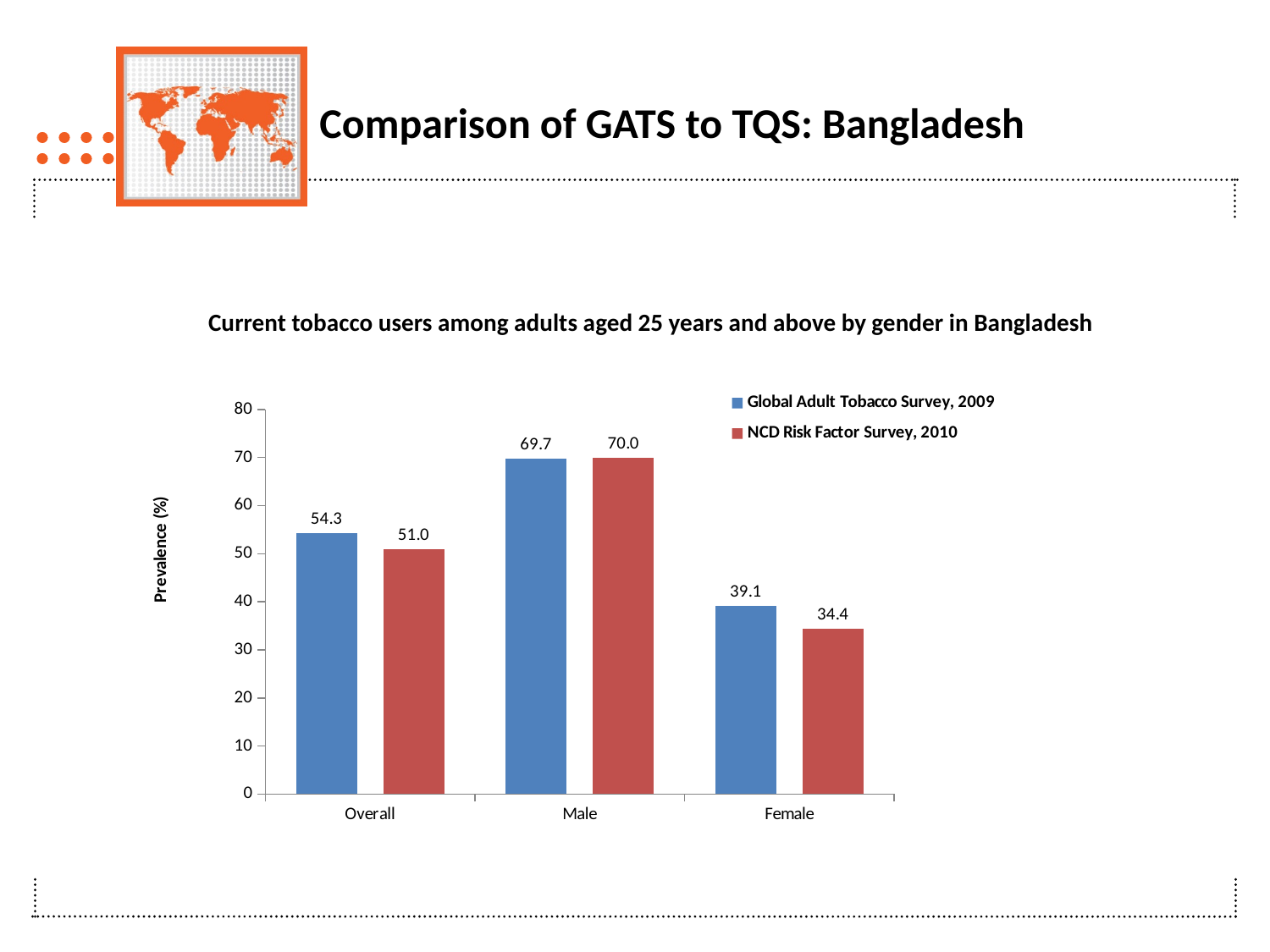
For Overall, which series has the larger value: Global Adult Tobacco Survey, 2009 or NCD Risk Factor Survey, 2010? Global Adult Tobacco Survey, 2009 What is the value for Female in the NCD Risk Factor Survey, 2010 series? 34.4 What is the value for Male in the Global Adult Tobacco Survey, 2009 series? 69.7 How many categories are shown on the x axis? 3 What is the difference between the Global Adult Tobacco Survey, 2009 and NCD Risk Factor Survey, 2010 values for Female? 4.7 What kind of chart is shown on the slide? bar chart What is the label of the y axis? Prevalence (%) How many series does the legend list? 2 Which category has the highest value in the Global Adult Tobacco Survey, 2009 series? Male Which category has the lowest value in the NCD Risk Factor Survey, 2010 series? Female What is the value for Overall in the NCD Risk Factor Survey, 2010 series? 51.0 What is the difference between the Global Adult Tobacco Survey, 2009 and NCD Risk Factor Survey, 2010 values for Overall? 3.3